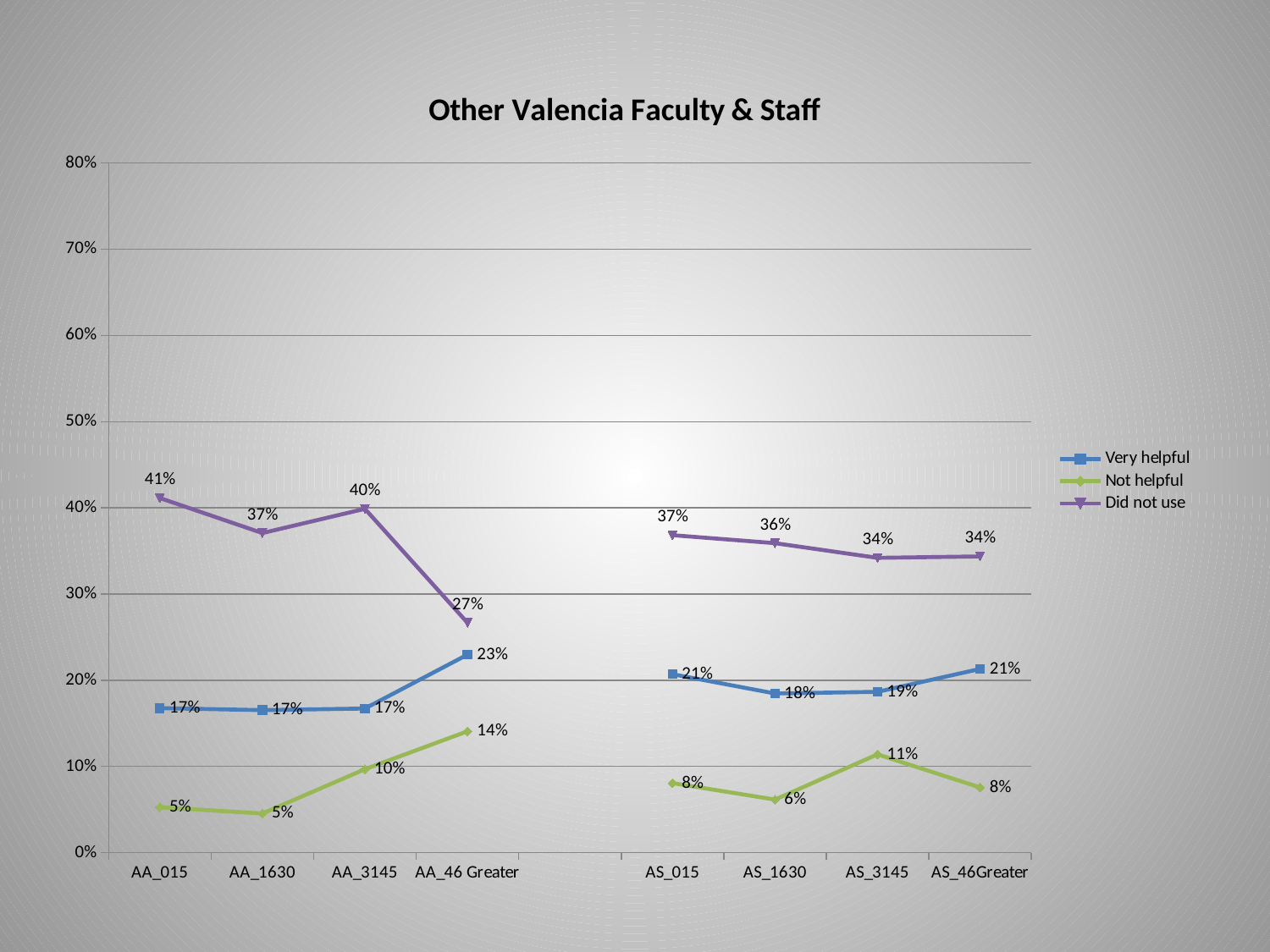
What kind of chart is shown on the slide? line chart Which category has the lowest value for Did not use? AA_46 Greater Which is larger, the Very helpful value at AS_015 or at AS_1630? AS_015 How many labeled categories are on the x axis? 8 What is the value for Not helpful at AS_3145? 11% What is the title of the chart? Other Valencia Faculty & Staff What is the difference between the Did not use values at AA_3145 and AA_46 Greater? 13% What is the value for Did not use at AA_015? 41% What is the value for Very helpful at AA_46 Greater? 23% How many series does the legend list? 3 Which category has the highest value for Did not use? AA_015 Is the value for Did not use at AS_015 greater or less than 30%? greater